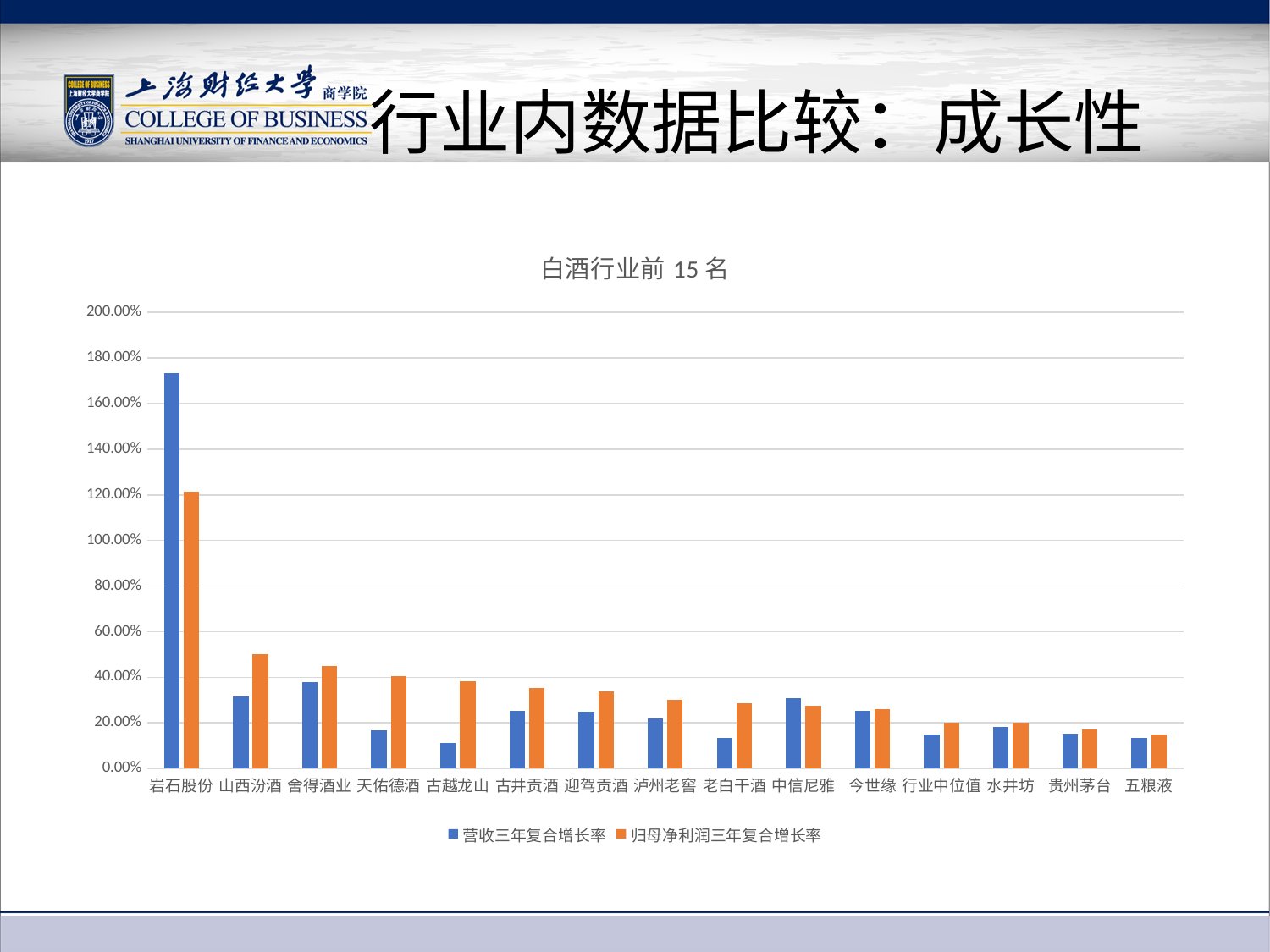
What kind of chart is shown on the slide? bar chart For 天佑德酒, which is larger: 营收三年复合增长率 or 归母净利润三年复合增长率? 归母净利润三年复合增长率 How many categories are shown on the x axis? 15 How many series does the legend list? 2 Is the 营收三年复合增长率 for 古越龙山 greater or less than 20.00%? less Which series is shown in orange in the legend? 归母净利润三年复合增长率 Is the 归母净利润三年复合增长率 for 山西汾酒 greater or less than 40.00%? greater Which category has the highest 归母净利润三年复合增长率? 岩石股份 Is the 营收三年复合增长率 for 岩石股份 greater or less than 160.00%? greater Which category has the highest 营收三年复合增长率? 岩石股份 What is the title of the chart? 白酒行业前 15 名